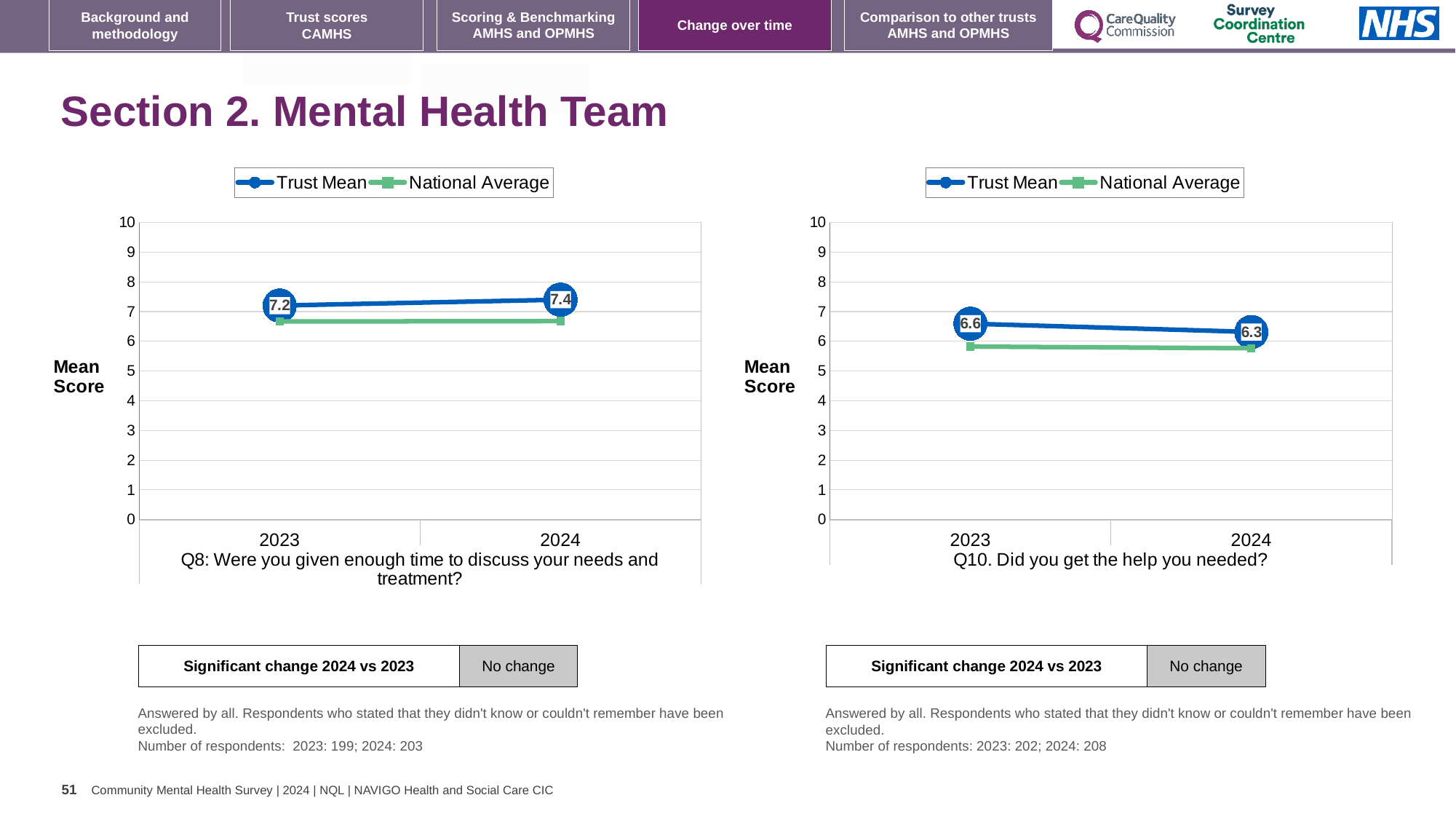
In the left chart (Q8), is the National Average for 2024 greater or less than 7? less What kind of chart is the right chart (Q10)? line chart In the left chart (Q8), what is the Trust Mean for 2024? 7.4 In the right chart (Q10), is the National Average for 2023 greater or less than 6? less How many series does the legend of the left chart (Q8) list? 2 In the right chart (Q10), what is the difference between the Trust Mean in 2023 and in 2024? 0.3 In the left chart (Q8), does the Trust Mean rise or fall from 2023 to 2024? rise In the left chart (Q8), what is the difference between the Trust Mean in 2024 and in 2023? 0.2 In the right chart (Q10. Did you get the help you needed?), what is the Trust Mean for 2023? 6.6 In the left chart (Q8: Were you given enough time to discuss your needs and treatment?), what is the Trust Mean for 2023? 7.2 In the right chart (Q10), does the Trust Mean rise or fall from 2023 to 2024? fall In the right chart (Q10), what is the Trust Mean for 2024? 6.3